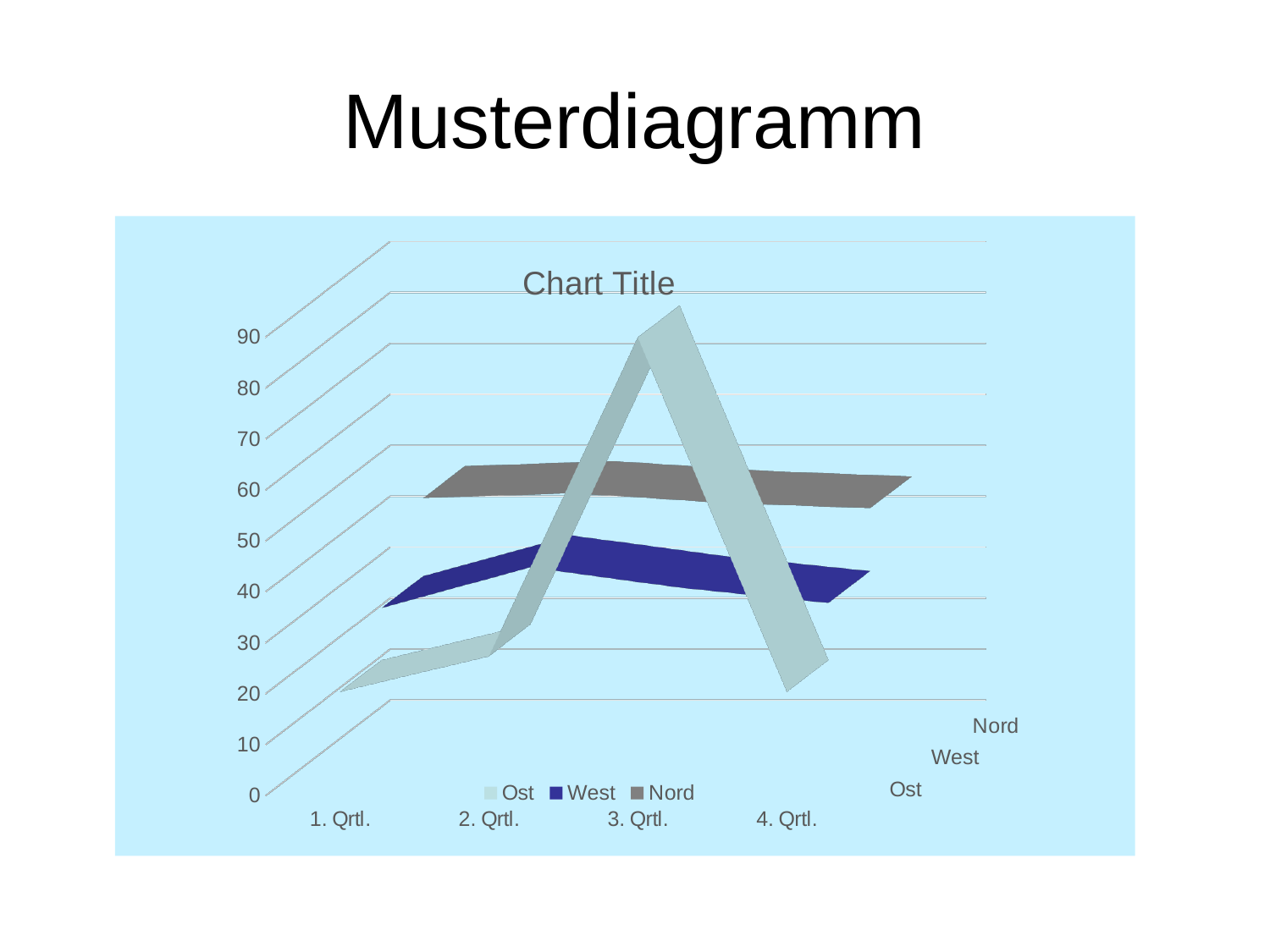
How many categories are shown on the x axis? 4 What are the series names listed in the legend? Ost, West, Nord Is the value for Ost in 3. Qrtl. greater or less than 80? greater In which quarter does the Ost series reach its highest value? 3. Qrtl. Is the value for Ost in 1. Qrtl. greater or less than 30? less Does the Ost series rise or fall from 1. Qrtl. to 3. Qrtl.? rise Is the value for Ost in 4. Qrtl. greater or less than 40? less What is the title shown on the chart? Chart Title Does the Ost series rise or fall from 3. Qrtl. to 4. Qrtl.? fall How many series does the legend list? 3 Which is larger for the Ost series: the value in 3. Qrtl. or the value in 1. Qrtl.? 3. Qrtl. What kind of chart is shown on the slide? line chart